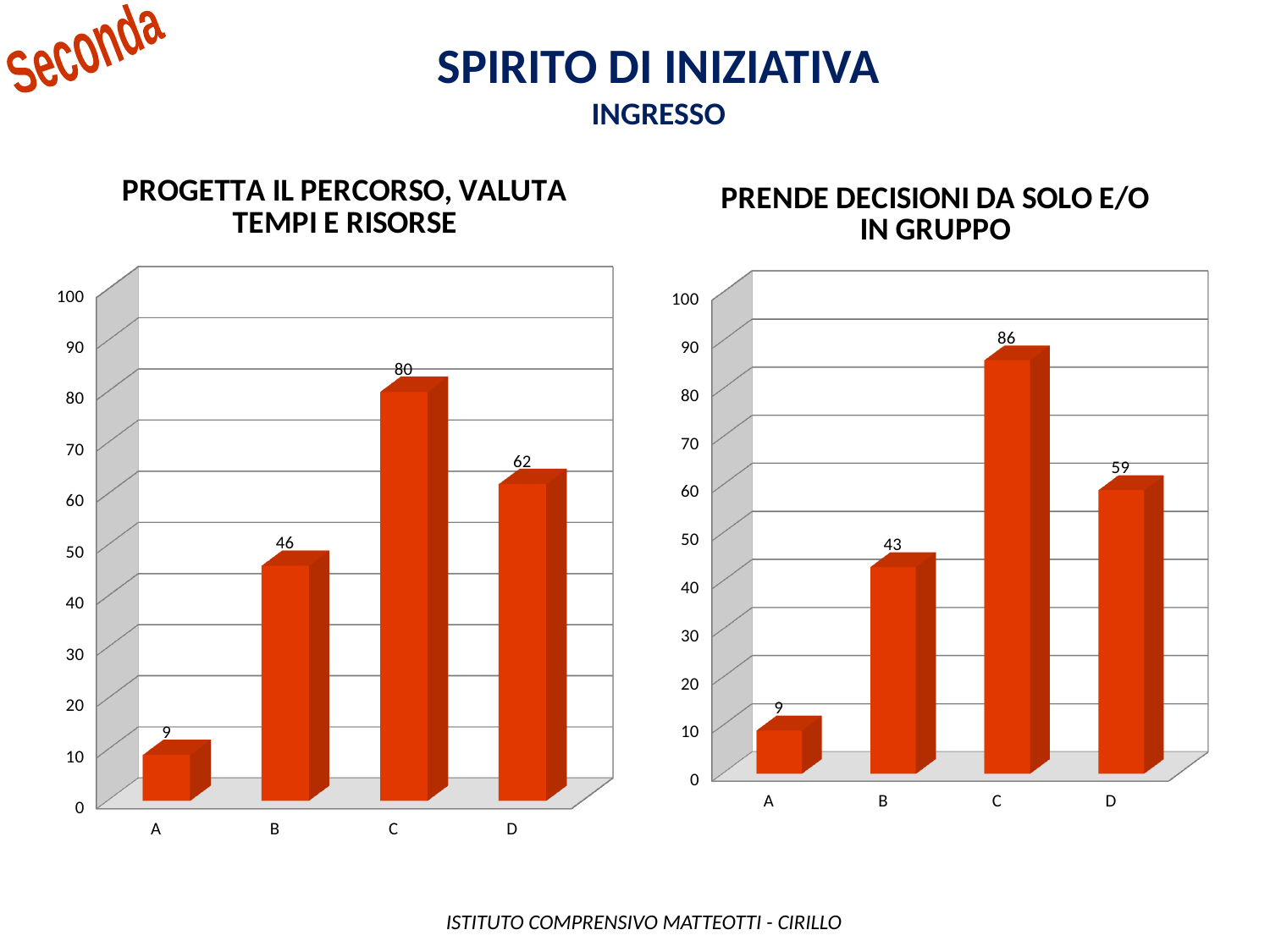
How many categories are shown in the chart titled 'PROGETTA IL PERCORSO, VALUTA TEMPI E RISORSE'? 4 In the chart titled 'PRENDE DECISIONI DA SOLO E/O IN GRUPPO', which category has the highest value? C In the chart titled 'PROGETTA IL PERCORSO, VALUTA TEMPI E RISORSE', which is larger, the value for B or the value for D? D In the chart titled 'PRENDE DECISIONI DA SOLO E/O IN GRUPPO', is the value for D greater or less than 50? greater In the chart titled 'PROGETTA IL PERCORSO, VALUTA TEMPI E RISORSE', what is the difference between the values for C and D? 18 What is the main title at the top of the slide? SPIRITO DI INIZIATIVA In the chart titled 'PROGETTA IL PERCORSO, VALUTA TEMPI E RISORSE', which category has the lowest value? A What kind of chart is the chart titled 'PRENDE DECISIONI DA SOLO E/O IN GRUPPO'? Bar chart In the chart titled 'PROGETTA IL PERCORSO, VALUTA TEMPI E RISORSE', what is the value for category A? 9 In the chart titled 'PRENDE DECISIONI DA SOLO E/O IN GRUPPO', what is the difference between the values for C and A? 77 In the chart titled 'PROGETTA IL PERCORSO, VALUTA TEMPI E RISORSE', what is the value for category C? 80 In the chart titled 'PRENDE DECISIONI DA SOLO E/O IN GRUPPO', what is the value for category B? 43